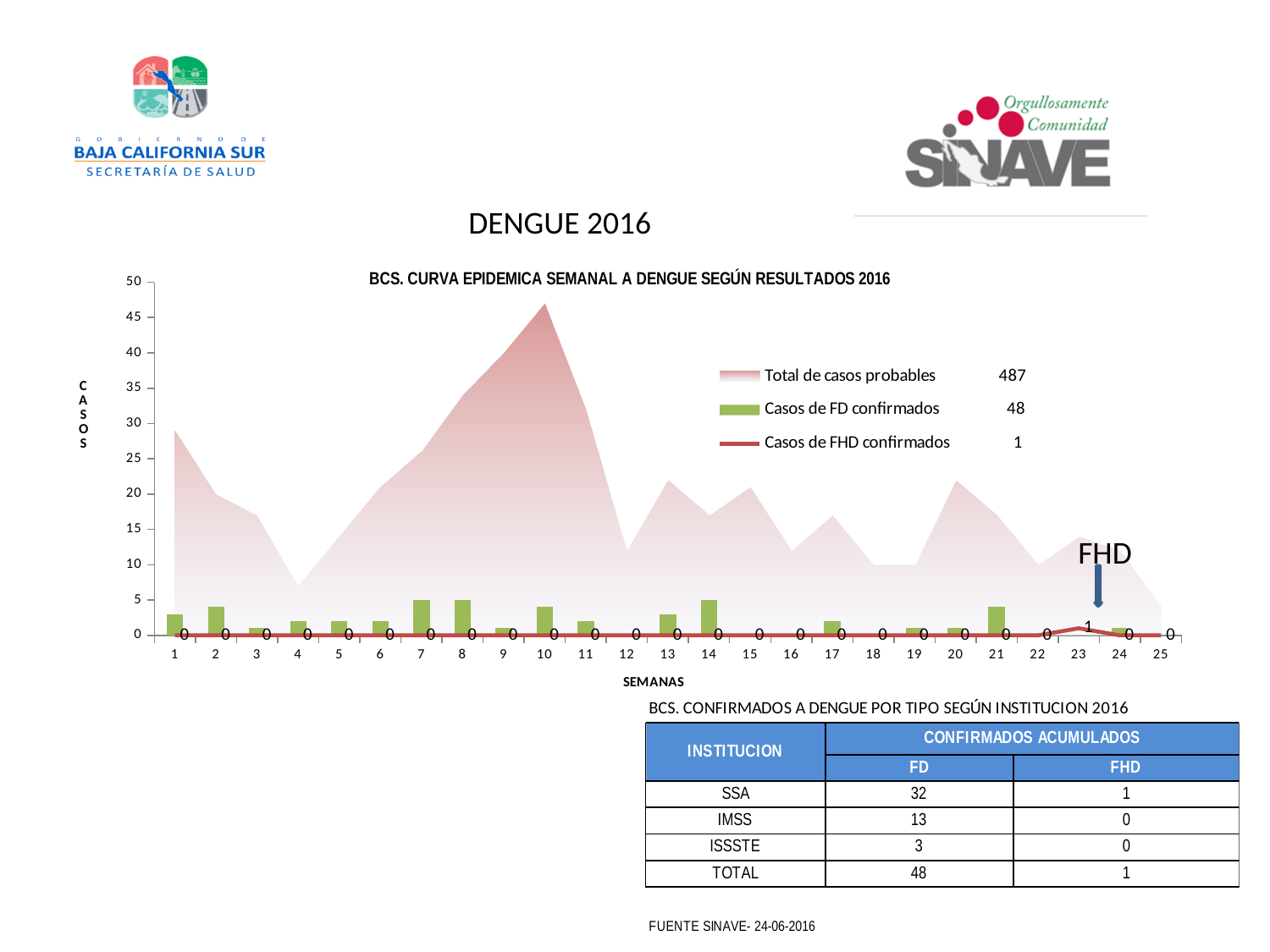
In which week is the value for Casos de FHD confirmados highest? 23 How many Casos de FHD confirmados are labelled for week 10? 0 What total is printed next to 'Casos de FD confirmados' in the legend? 48 Does the Total de casos probables rise or fall from week 4 to week 10? rise What total is printed next to 'Total de casos probables' in the legend? 487 How many series does the legend of the chart list? 3 What is the title of the x axis of the chart? SEMANAS What kind of chart is used to plot Casos de FD confirmados? bar chart How many Casos de FHD confirmados are labelled for week 23? 1 Is the value for Total de casos probables in week 10 greater or less than 40? greater How many weeks are shown on the x axis of the chart? 25 Is the value for Total de casos probables in week 4 greater or less than 10? less